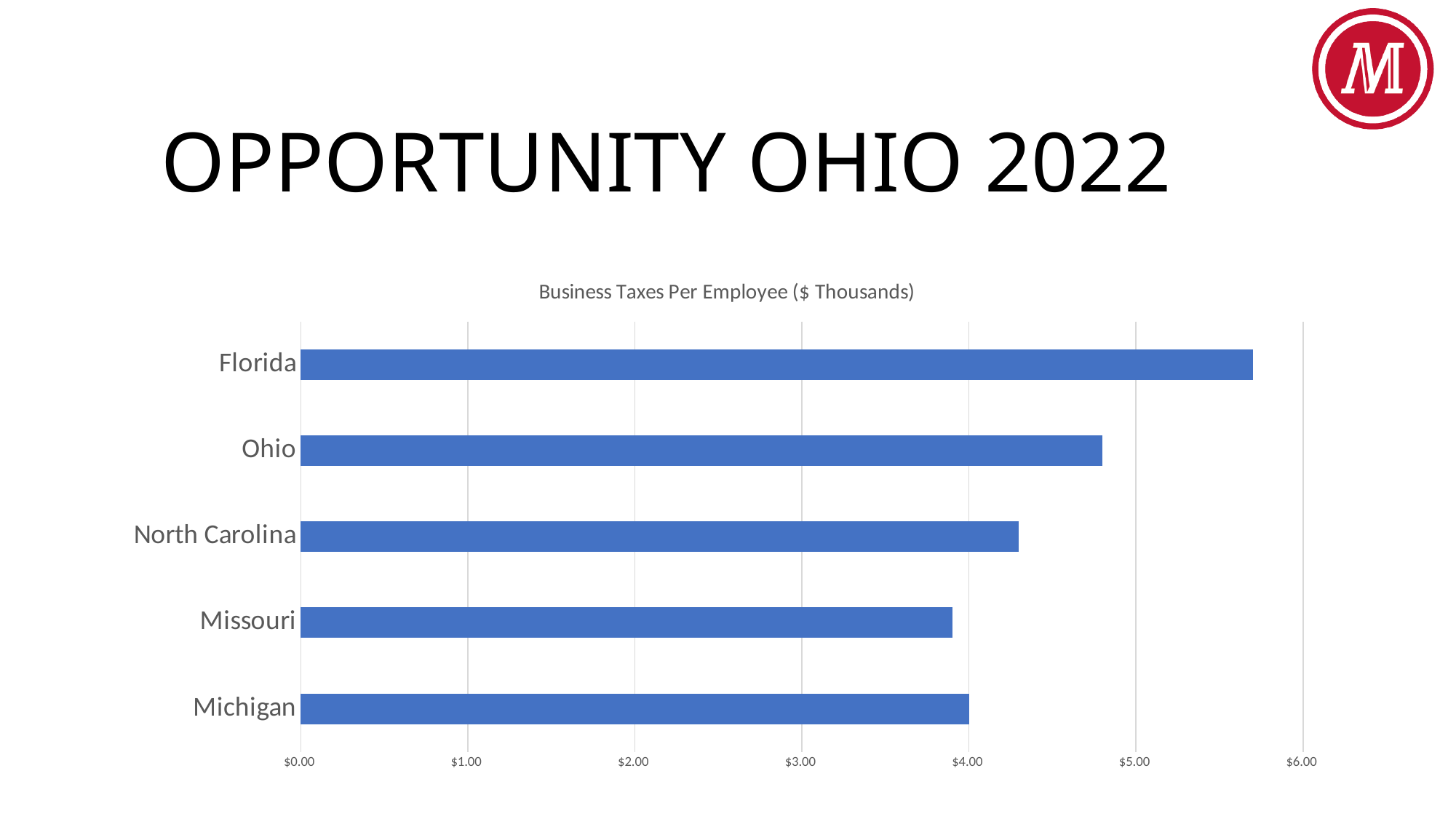
Is the value for Missouri greater or less than $4.00? less What is the value for Michigan? $4.00 Which is larger, the value for Ohio or the value for North Carolina? Ohio Which state has the highest business taxes per employee? Florida How many states are shown in the chart? 5 Is the value for Florida greater or less than $5.00? greater Is the value for North Carolina greater or less than $4.00? greater What colour are the bars in the chart? blue What kind of chart is shown on the slide? bar chart What is the title of the chart? Business Taxes Per Employee ($ Thousands) Which is larger, the value for Florida or the value for Ohio? Florida